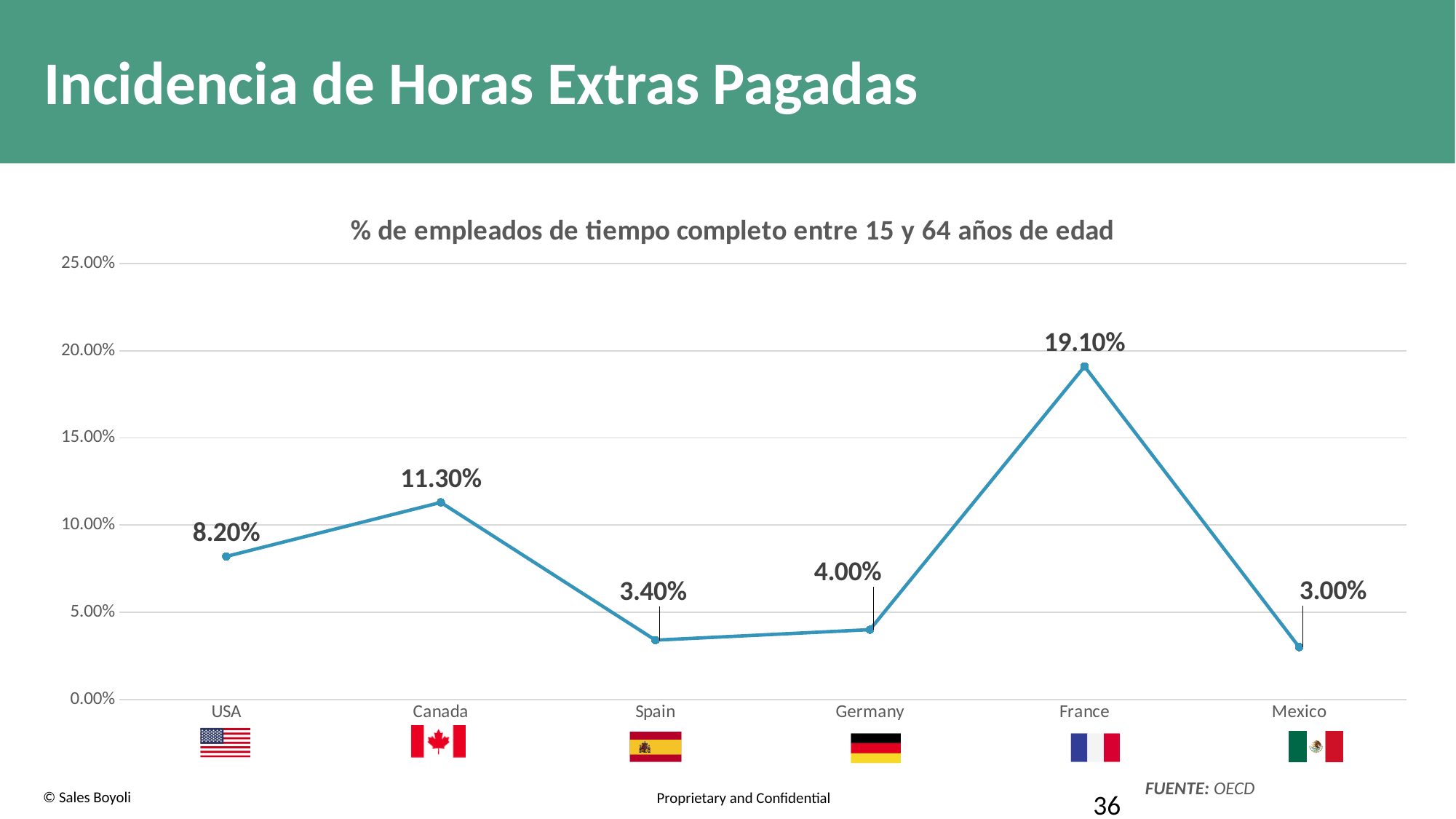
What kind of chart is shown on the slide? line chart How many countries are shown on the x axis? 6 What is the value for France? 19.10% What is the value for Canada? 11.30% Is the value for USA greater or less than 10.00%? less Which country has the lowest value? Mexico What is the difference between the values for France and Mexico? 16.10% Which is larger, the value for Germany or the value for Spain? Germany What is the difference between the values for Canada and USA? 3.10% What is the value for Spain? 3.40% Which country has the highest value? France What is the title of the chart? % de empleados de tiempo completo entre 15 y 64 años de edad